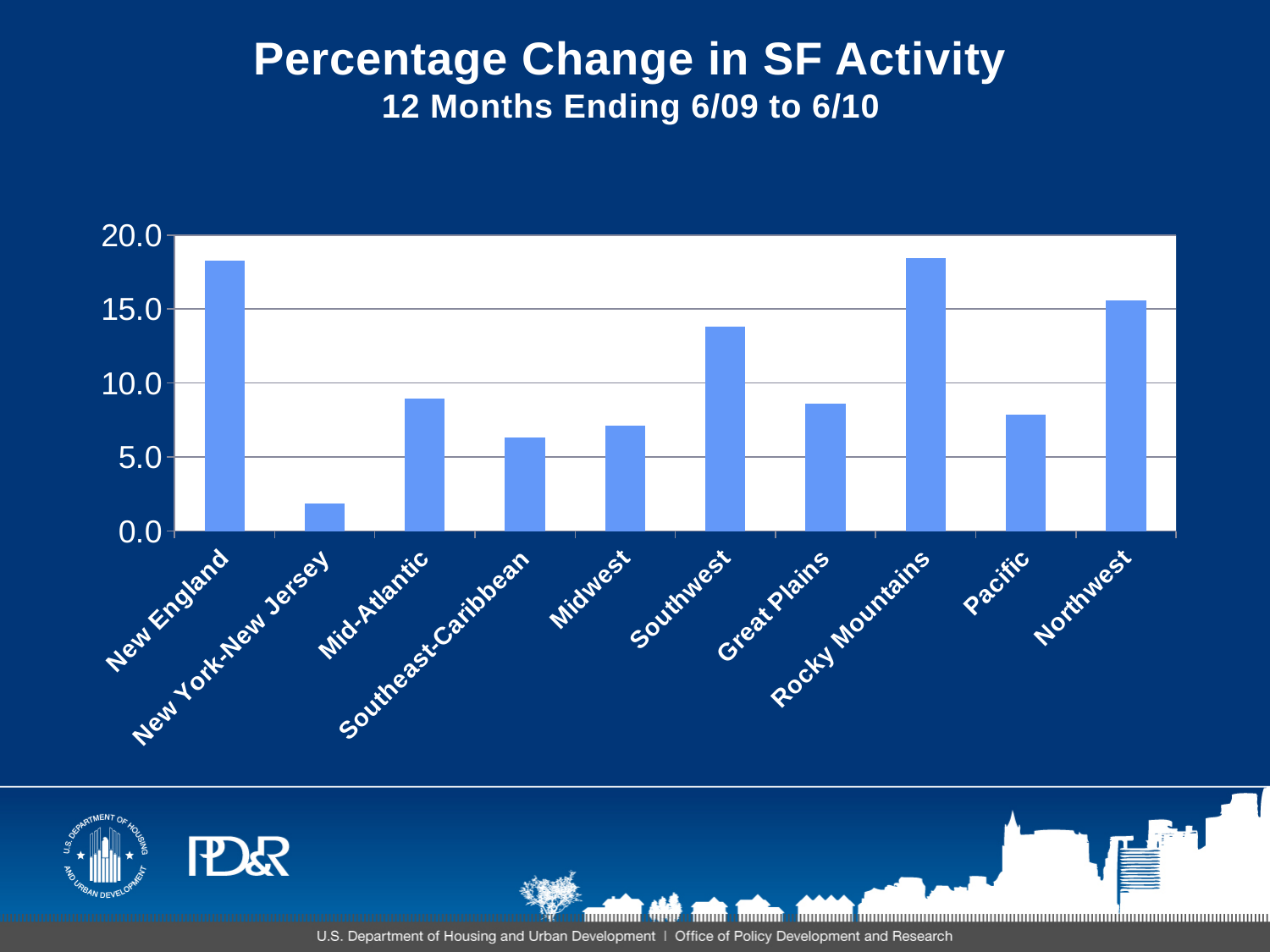
What time period does the chart subtitle say the data covers? 12 Months Ending 6/09 to 6/10 Is the value for Rocky Mountains greater or less than 15.0? greater Is the value for Pacific greater or less than 10.0? less Is the value for Southwest greater or less than 10.0? greater Which region has the lowest percentage change in SF activity? New York-New Jersey How many regions are shown on the x axis of the chart? 10 Which is larger, the value for Mid-Atlantic or the value for New York-New Jersey? Mid-Atlantic What kind of chart is shown on the slide? bar chart Which is larger, the value for Southwest or the value for Northwest? Northwest